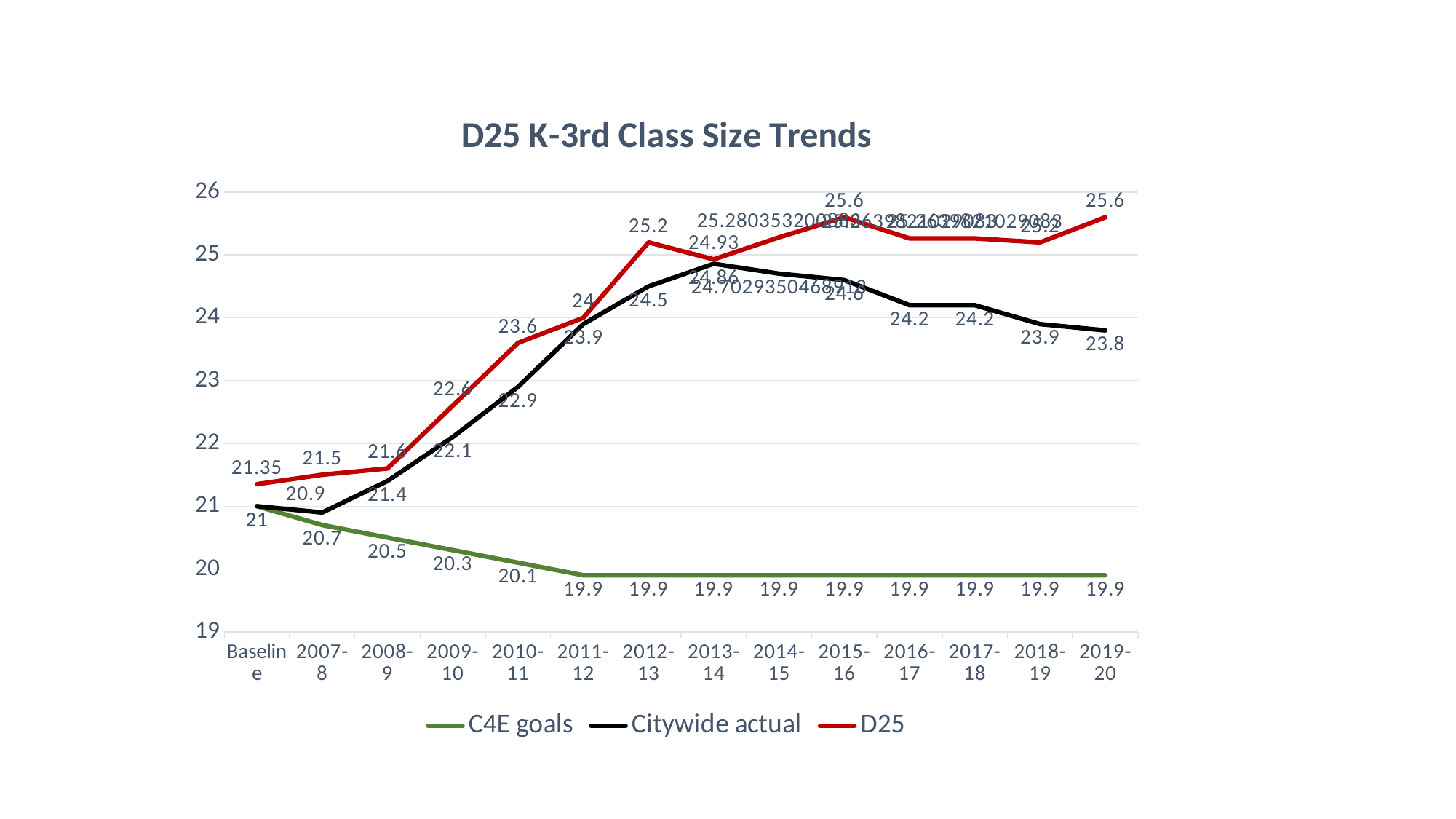
What type of chart is shown on the slide? line chart What is the C4E goals value for 2009-10? 20.3 What is the difference between the D25 value and the Citywide actual value for 2019-20? 1.8 What is the D25 value at Baseline? 21.35 How many categories are shown on the x axis? 14 What is the title of the chart? D25 K-3rd Class Size Trends For 2012-13, which is larger: the D25 value or the Citywide actual value? D25 In which category is the Citywide actual series lowest? 2007-8 Is the C4E goals value for 2019-20 greater or less than 20? less What is the Citywide actual value for 2019-20? 23.8 How many series does the legend list? 3 What is the D25 value for 2012-13? 25.2